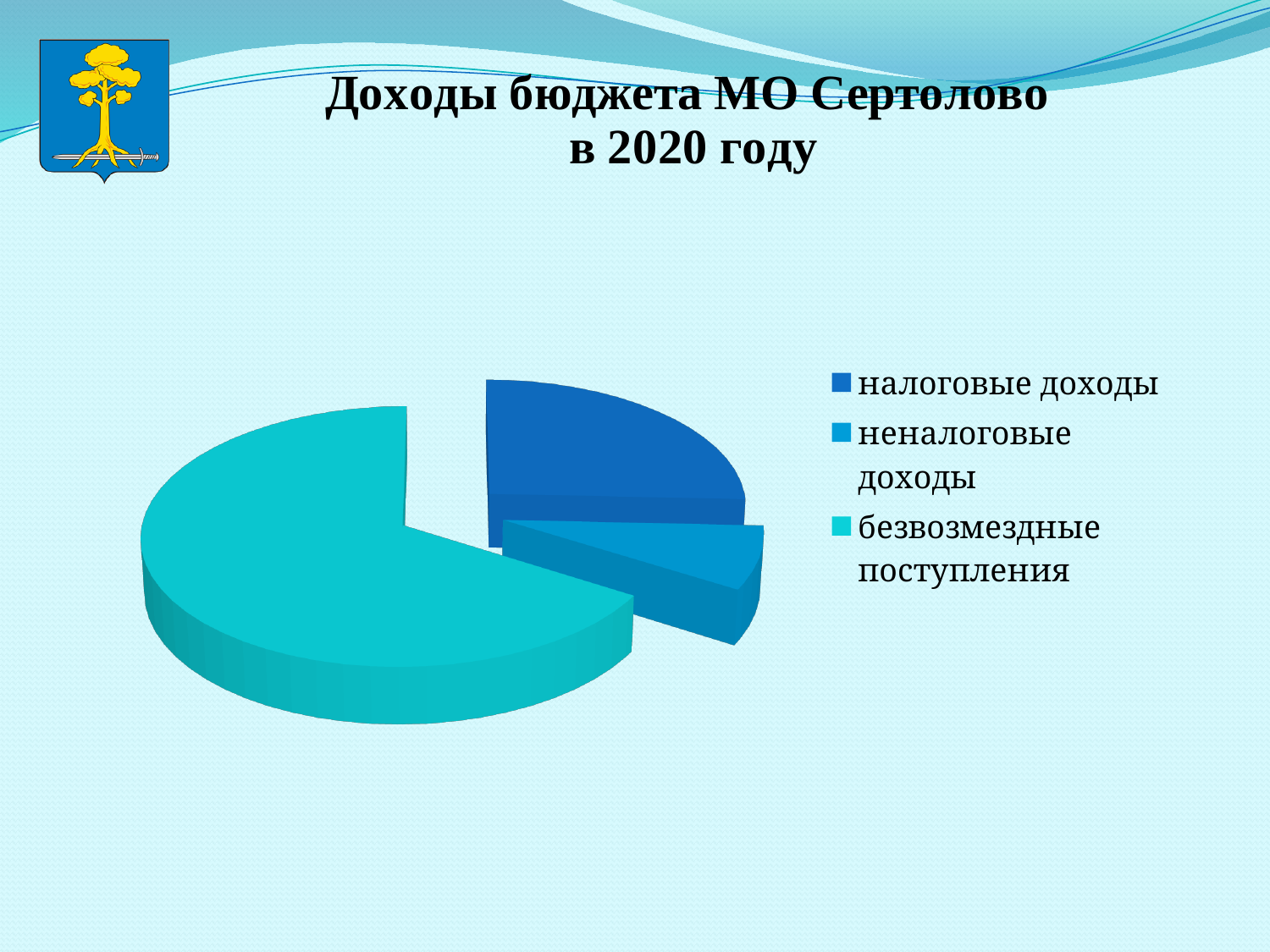
What is the title of the chart on the slide? Доходы бюджета МО Сертолово в 2020 году What kind of chart is shown on the slide? pie chart Which slice is larger: налоговые доходы or неналоговые доходы? налоговые доходы Which slice is larger: безвозмездные поступления or налоговые доходы? безвозмездные поступления Which legend entry is shown in the darkest blue colour? налоговые доходы Which category has the largest slice of the pie chart? безвозмездные поступления Which category has the smallest slice of the pie chart? неналоговые доходы Does the slice for безвозмездные поступления take up more or less than half of the pie? more How many slices does the pie chart have? 3 How many entries does the legend of the pie chart list? 3